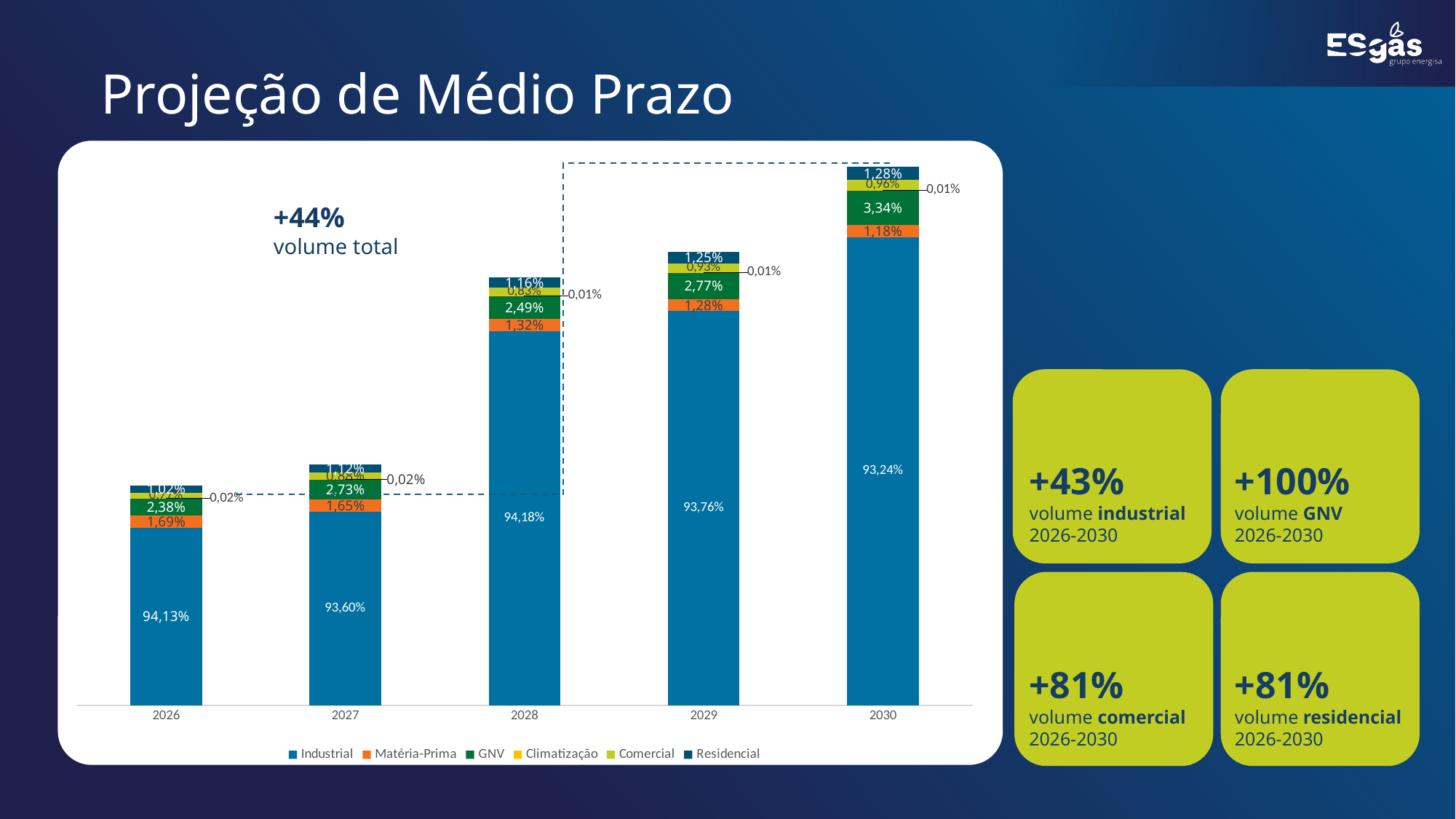
What is the GNV share shown for 2030? 3,34% What total volume growth is annotated on the chart? +44% What kind of chart is shown on the slide? Stacked bar chart What is the Residencial share shown for 2029? 1,25% What is the Matéria-Prima share shown for 2028? 1,32% How many series does the chart legend list? 6 What is the difference between the Industrial share labels for 2028 and 2030? 0,94% Which year has the highest GNV share label, 2027 or 2030? 2030 Which year has the tallest bar in the chart? 2030 How many years are shown on the x axis of the chart? 5 What is the Industrial share shown for 2026? 94,13% Which year has the shortest bar in the chart? 2026